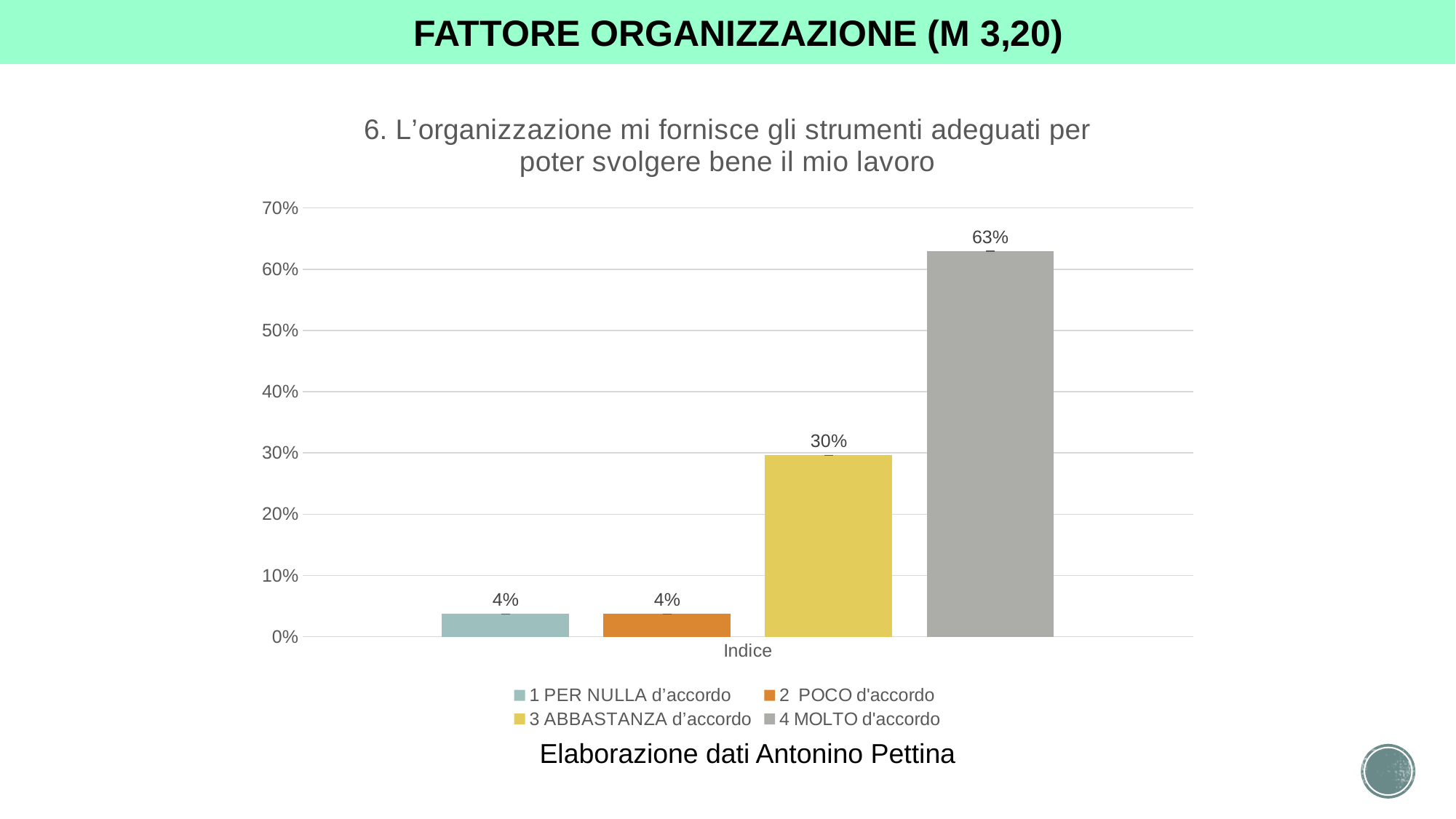
Which is larger, the value for '3 ABBASTANZA d'accordo' or the value for '4 MOLTO d'accordo'? 4 MOLTO d'accordo Which series has the highest value? 4 MOLTO d'accordo What is the difference between the values for '3 ABBASTANZA d'accordo' and '2 POCO d'accordo'? 26% How many series does the legend list? 4 What value is shown for '4 MOLTO d'accordo'? 63% What is the difference between the values for '4 MOLTO d'accordo' and '3 ABBASTANZA d'accordo'? 33% What kind of chart is shown on the slide? bar chart What value is shown for '1 PER NULLA d'accordo'? 4% What is the label on the x axis of the chart? Indice Is the value for '4 MOLTO d'accordo' greater or less than 50%? greater What value is shown for '3 ABBASTANZA d'accordo'? 30% What value is shown for '2 POCO d'accordo'? 4%